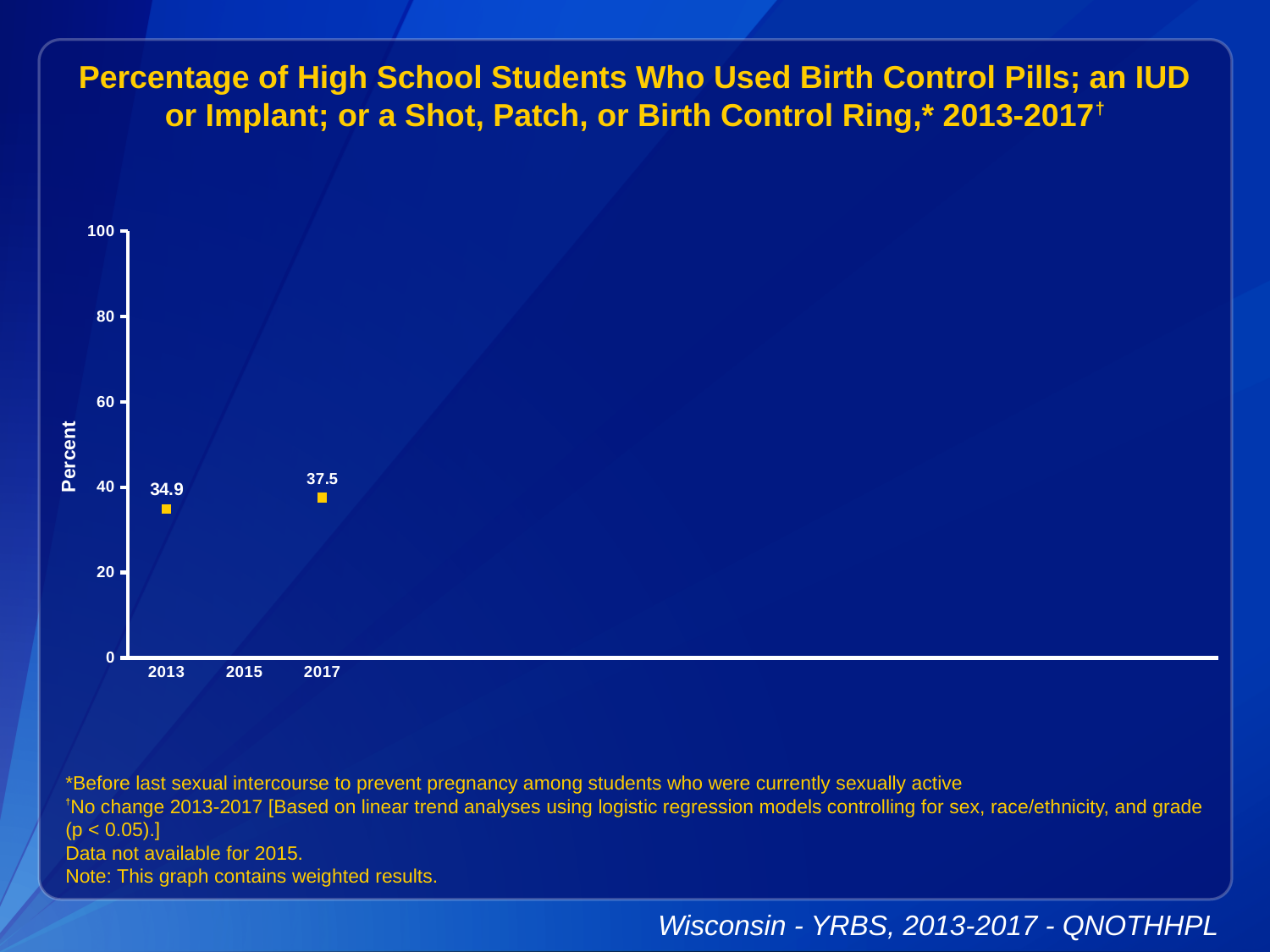
Do the plotted values rise or fall from 2013 to 2017? rise Which is larger, the value for 2013 or the value for 2017? 2017 What is the label on the y axis? Percent Is the value for 2013 greater or less than 40? less Is the value for 2017 greater or less than 20? greater What is the difference between the 2017 and 2013 values? 2.6 Which year has the lowest plotted value? 2013 What is the value for 2017? 37.5 For which year is data not available? 2015 How many data points are plotted on the chart? 2 Which year has the highest value? 2017 What is the value for 2013? 34.9